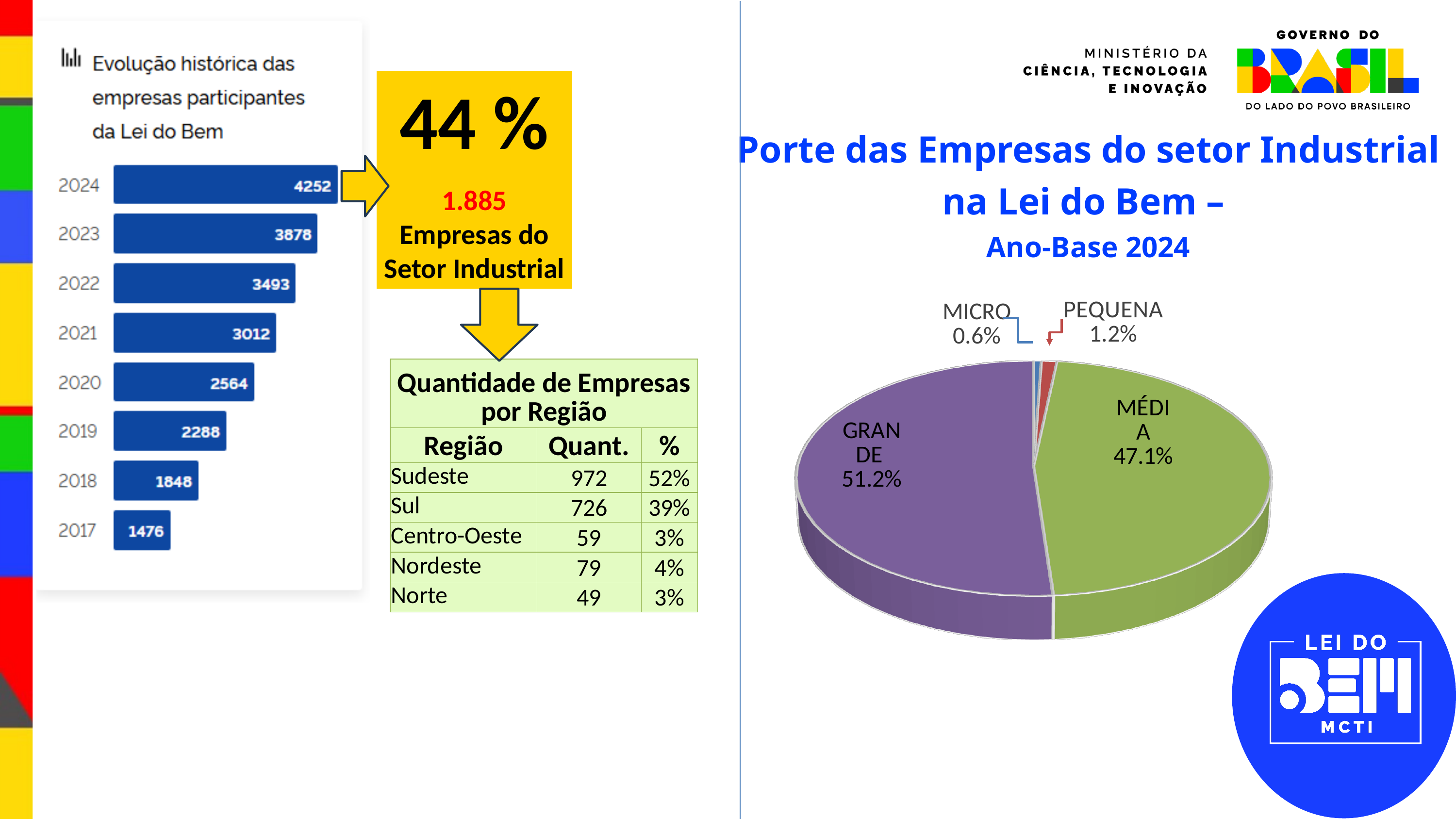
In the bar chart 'Evolução histórica das empresas participantes da Lei do Bem', what is the value for 2024? 4252 What kind of chart is 'Evolução histórica das empresas participantes da Lei do Bem'? bar chart In the pie chart 'Porte das Empresas do setor Industrial na Lei do Bem – Ano-Base 2024', which category has the smallest slice? MICRO In the bar chart 'Evolução histórica das empresas participantes da Lei do Bem', which year has the highest value? 2024 In the bar chart 'Evolução histórica das empresas participantes da Lei do Bem', what is the difference between the values for 2024 and 2023? 374 In the bar chart 'Evolução histórica das empresas participantes da Lei do Bem', what is the value for 2020? 2564 In the pie chart 'Porte das Empresas do setor Industrial na Lei do Bem – Ano-Base 2024', which category has the largest slice? GRANDE In the bar chart 'Evolução histórica das empresas participantes da Lei do Bem', what is the value for 2017? 1476 In the bar chart 'Evolução histórica das empresas participantes da Lei do Bem', how many years are shown? 8 In the bar chart 'Evolução histórica das empresas participantes da Lei do Bem', do the values rise or fall from 2017 to 2024? rise In the bar chart 'Evolução histórica das empresas participantes da Lei do Bem', which year has the lowest value? 2017 In the pie chart 'Porte das Empresas do setor Industrial na Lei do Bem – Ano-Base 2024', what share does MÉDIA have? 47.1%